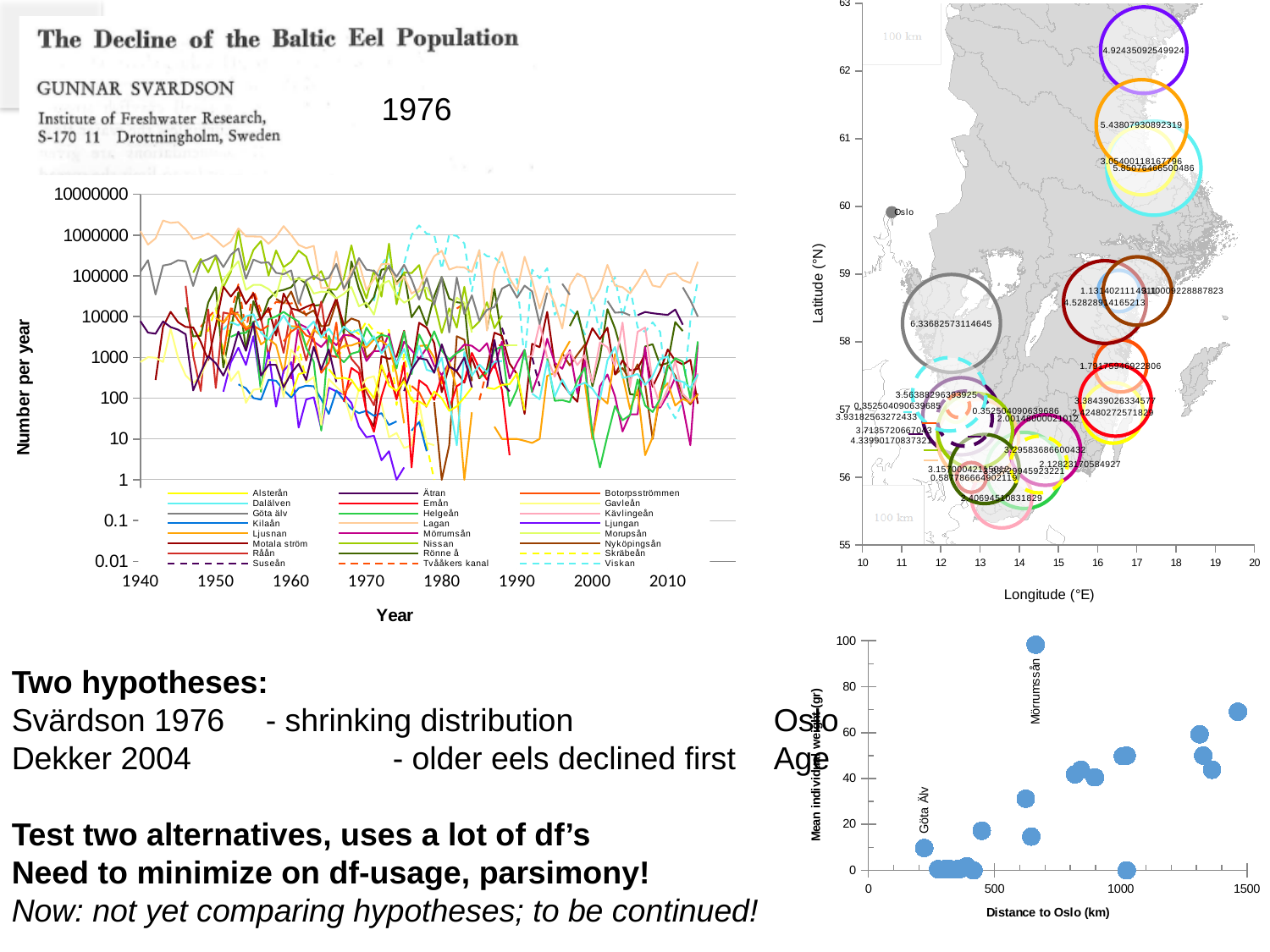
In the top-right map chart, what is the label of the x axis? Longitude (°E) In the top-left line chart, what is the highest value shown on the y axis? 10000000 In the bottom-right scatter chart, which labelled river has the highest mean individual weight? Mörrumsån In the bottom-right scatter chart, does mean individual weight generally rise or fall as distance to Oslo increases? rise In the top-left line chart, what is the label of the x axis? Year In the bottom-right scatter chart, is the mean individual weight for Mörrumsån greater or less than 80? greater In the top-left line chart, how many series does the legend list? 24 In the bottom-right scatter chart, is the mean individual weight for Göta Älv greater or less than 20? less What kind of chart is the chart in the top left with the y axis labelled 'Number per year'? line chart In the bottom-right scatter chart, which has the larger mean individual weight, Göta Älv or Mörrumsån? Mörrumsån